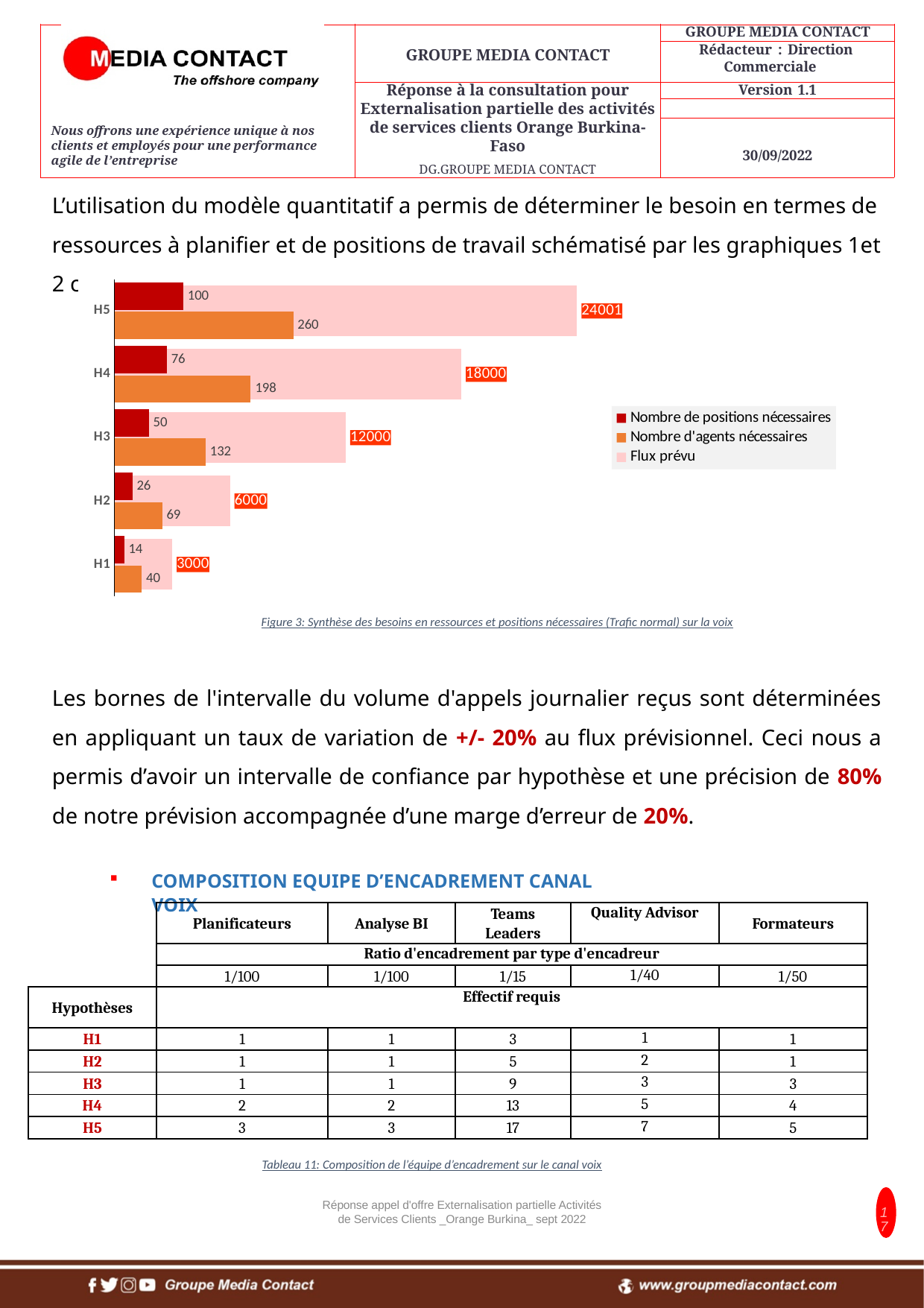
Which is larger: 'Nombre de positions nécessaires' for H2 or for H3? H3 How many series does the chart legend list? 3 What is the 'Flux prévu' value for H4? 18000 How many hypothesis categories (H1 to H5) are shown on the chart? 5 Which hypothesis has the lowest 'Nombre d'agents nécessaires'? H1 What is the difference between 'Nombre d'agents nécessaires' for H5 and H4? 62 What is the value of 'Nombre d'agents nécessaires' for H3? 132 Which hypothesis has the highest 'Flux prévu'? H5 What kind of chart is shown on the slide? bar chart What is the value of 'Nombre de positions nécessaires' for H5? 100 What is the 'Flux prévu' value for H1? 3000 Do the 'Flux prévu' values increase or decrease from H1 to H5? increase